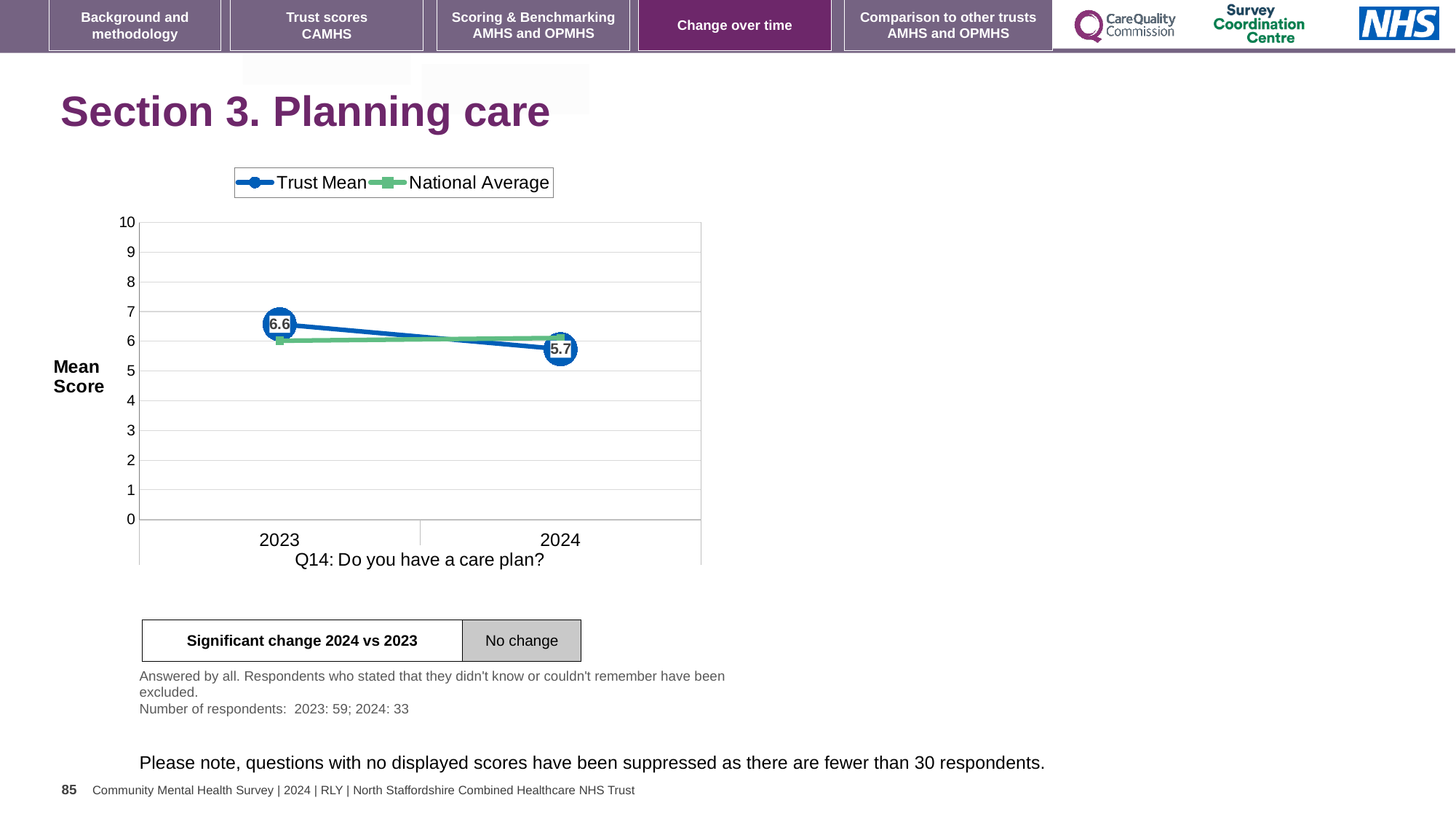
Is the National Average value for 2023 greater or less than 7? less Is the National Average value for 2024 greater or less than 5? greater In 2023, which series is higher, Trust Mean or National Average? Trust Mean What is the Trust Mean value for 2023? 6.6 How many series does the legend list? 2 By how much did the Trust Mean change from 2023 to 2024? 0.9 What is the Trust Mean value for 2024? 5.7 Which year has the higher Trust Mean, 2023 or 2024? 2023 In 2024, which series is higher, Trust Mean or National Average? National Average What kind of chart is shown on the slide? line chart Does the Trust Mean rise or fall from 2023 to 2024? fall How many years are shown on the x axis? 2